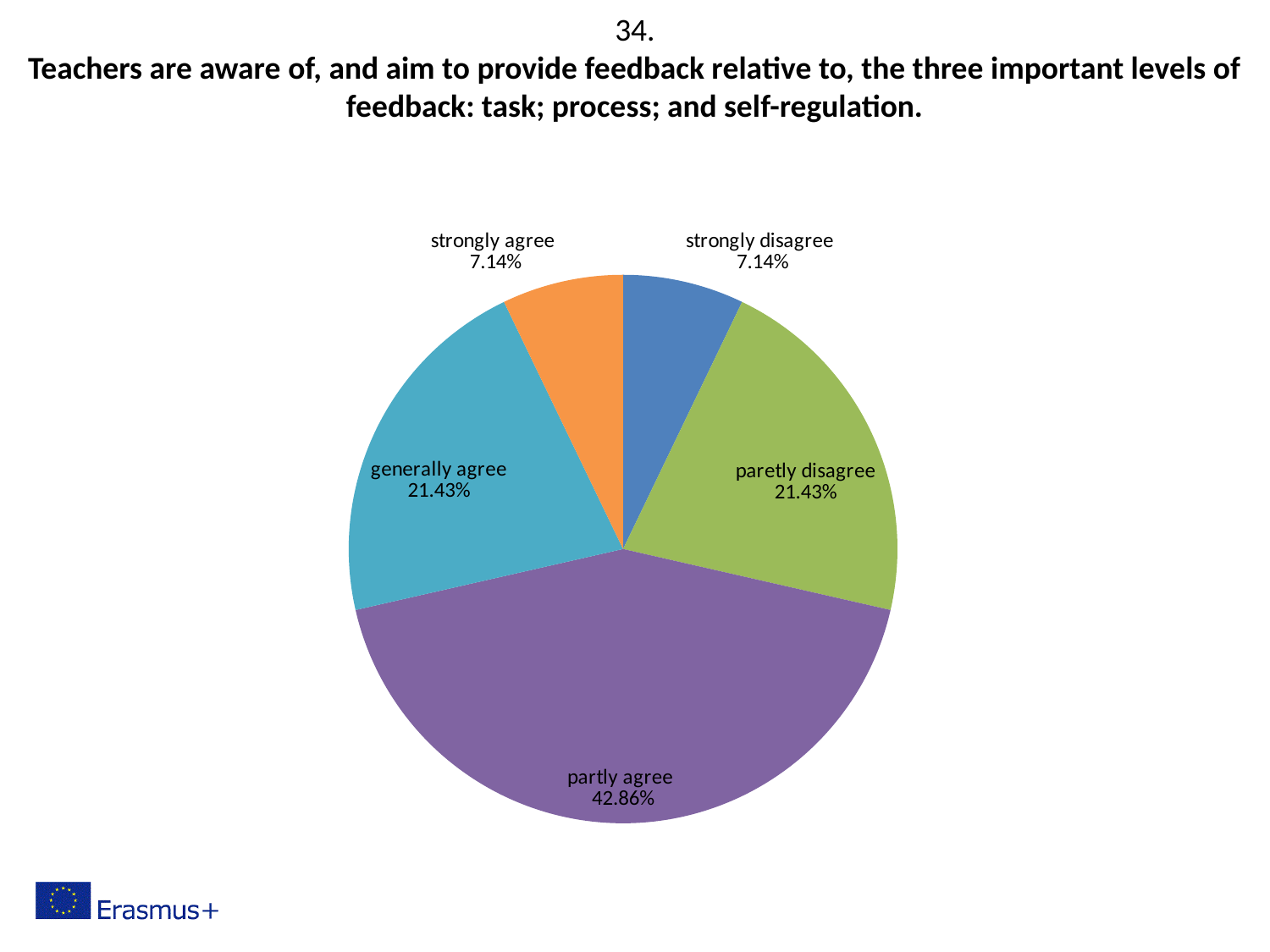
What share of the pie is labelled "strongly agree"? 7.14% What is the difference in percentage points between the "partly agree" slice and the "generally agree" slice? 21.43 What share of the pie is labelled "paretly disagree"? 21.43% Which category has the largest slice of the pie? partly agree What kind of chart is shown on the slide? pie chart What is the difference in percentage points between the "generally agree" slice and the "strongly agree" slice? 14.29 What colour is the "partly agree" slice? purple Which slice is larger, "partly agree" or "paretly disagree"? partly agree What share of the pie is labelled "partly agree"? 42.86% What share of the pie is labelled "generally agree"? 21.43% What share of the pie is labelled "strongly disagree"? 7.14% How many slices does the pie chart have? 5